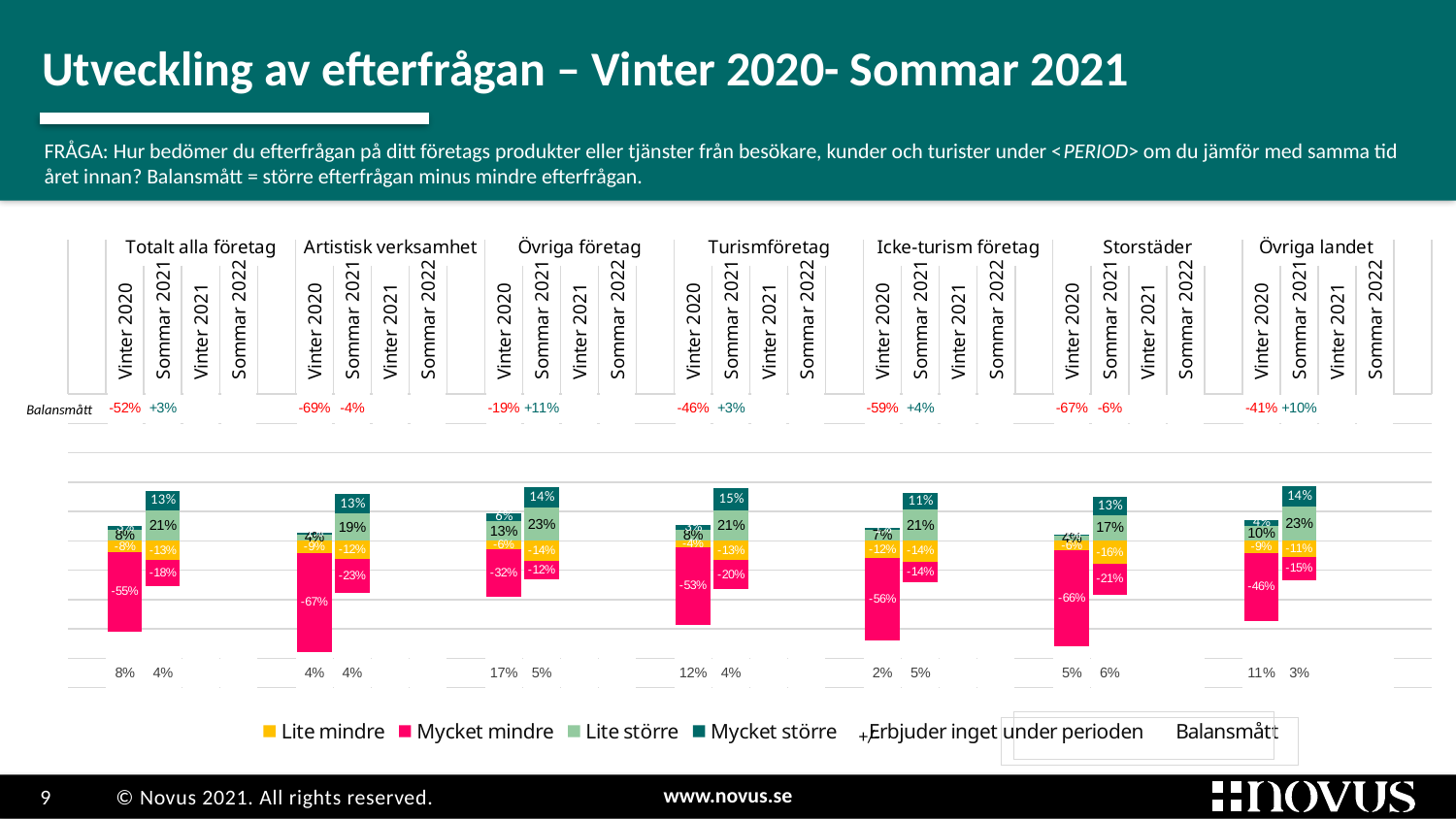
What is the difference between the Balansmått for Totalt alla företag in Sommar 2021 and in Vinter 2020? 55 percentage points Which group has the highest Balansmått for Sommar 2021? Övriga företag What type of chart is used on the slide? Stacked bar chart What percentage of Övriga företag answered Erbjuder inget under perioden for Vinter 2020? 17% How many company groups are shown in the chart? 7 What is the Balansmått for Övriga företag in Sommar 2021? +11% What is the Mycket större share for Turismföretag in Sommar 2021? 15% Is the Balansmått for Storstäder in Sommar 2021 higher or lower than for Övriga landet in Sommar 2021? lower How many entries does the legend list? 6 What is the Balansmått for Totalt alla företag in Vinter 2020? -52% What is the Mycket mindre share for Artistisk verksamhet in Vinter 2020? -67% Which group has the lowest Balansmått for Vinter 2020? Artistisk verksamhet